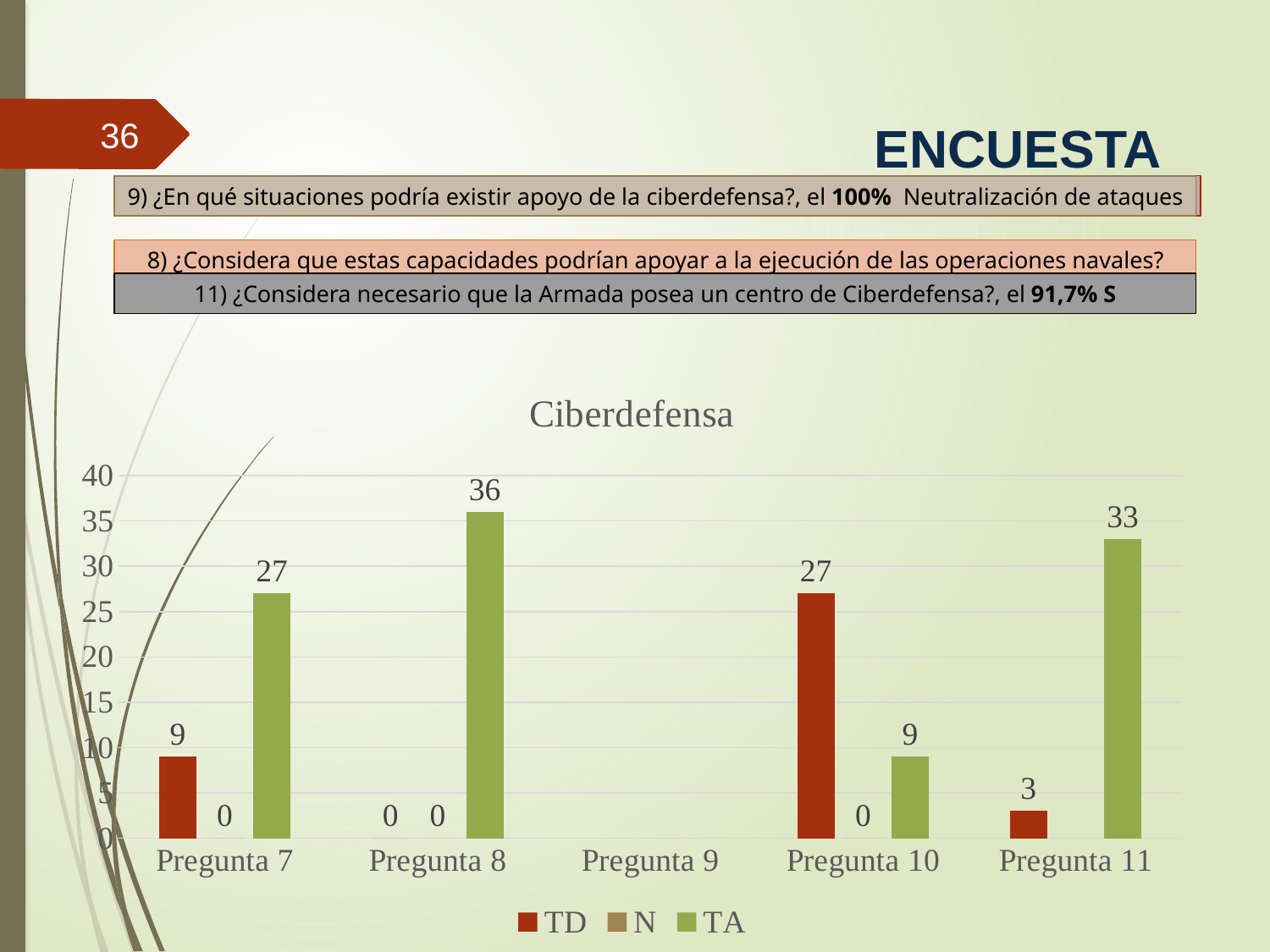
What is the title of the chart? Ciberdefensa What is the TD value for Pregunta 7? 9 What kind of chart is shown on the slide? bar chart What is the TA value for Pregunta 8? 36 What is the TD value for Pregunta 10? 27 Which category has the highest TA value? Pregunta 8 What is the TA value for Pregunta 11? 33 What is the difference between the TA values for Pregunta 8 and Pregunta 11? 3 For Pregunta 10, which is larger, the TD value or the TA value? TD How many series does the chart legend list? 3 How many categories are shown on the x axis of the chart? 5 Which category has the highest TD value? Pregunta 10